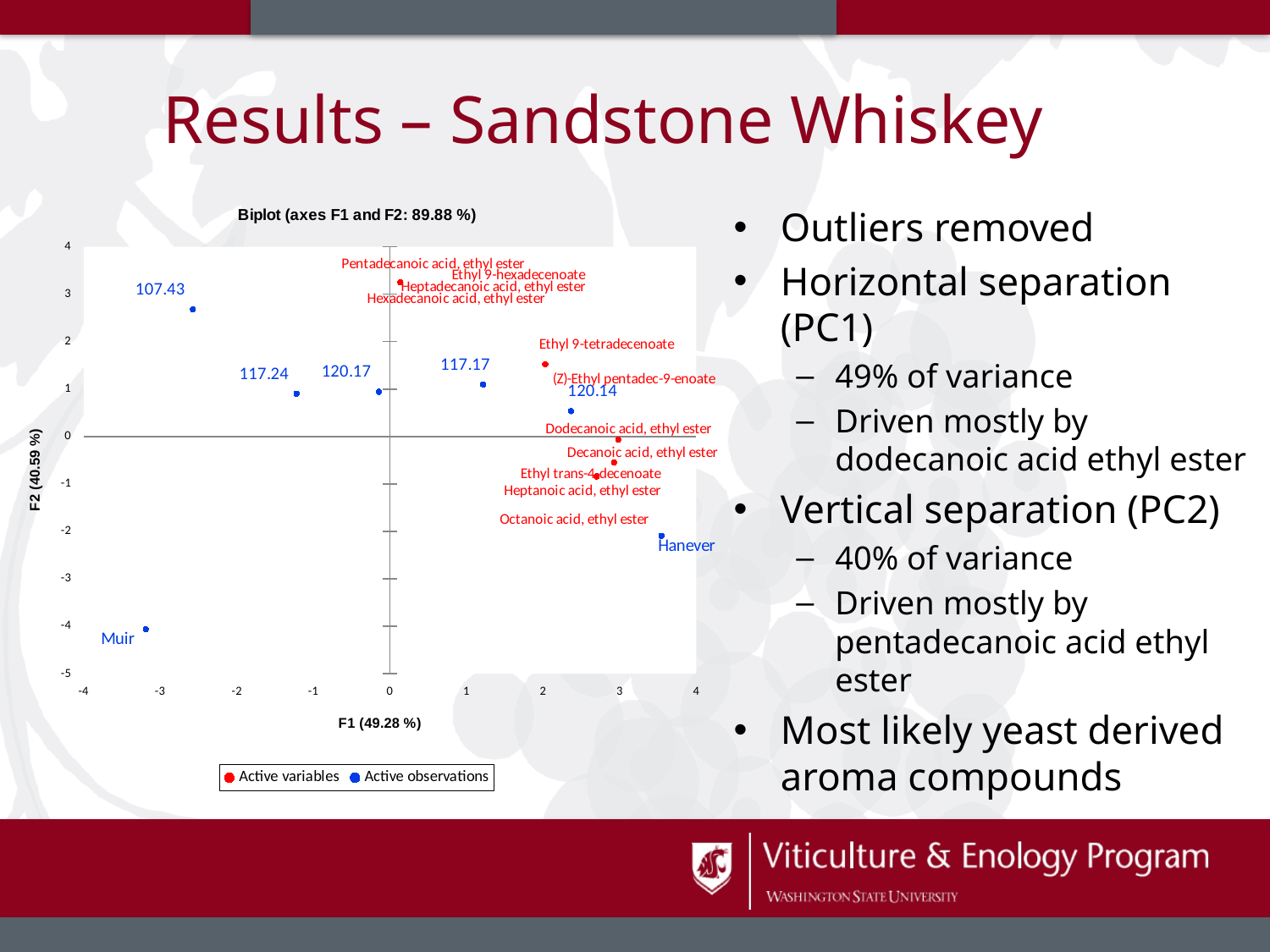
Is the F1 value for Hanever greater or less than 3? greater What kind of chart is shown on the slide? Scatter chart (biplot) What is the title of the chart? Biplot (axes F1 and F2: 89.88 %) What are the two legend entries of the biplot? Active variables, Active observations What percentage is shown in the F1 axis label of the biplot? 49.28 % Which active observation has the highest F2 value on the biplot? 107.43 Which has the larger F1 value on the biplot, Hanever or Muir? Hanever Which active observation has the lowest F2 value on the biplot? Muir How many series does the legend of the biplot list? 2 What percentage is shown in the F2 axis label of the biplot? 40.59 % How many blue active observation points are plotted on the biplot? 7 Is the F2 value for Muir greater or less than -3? less